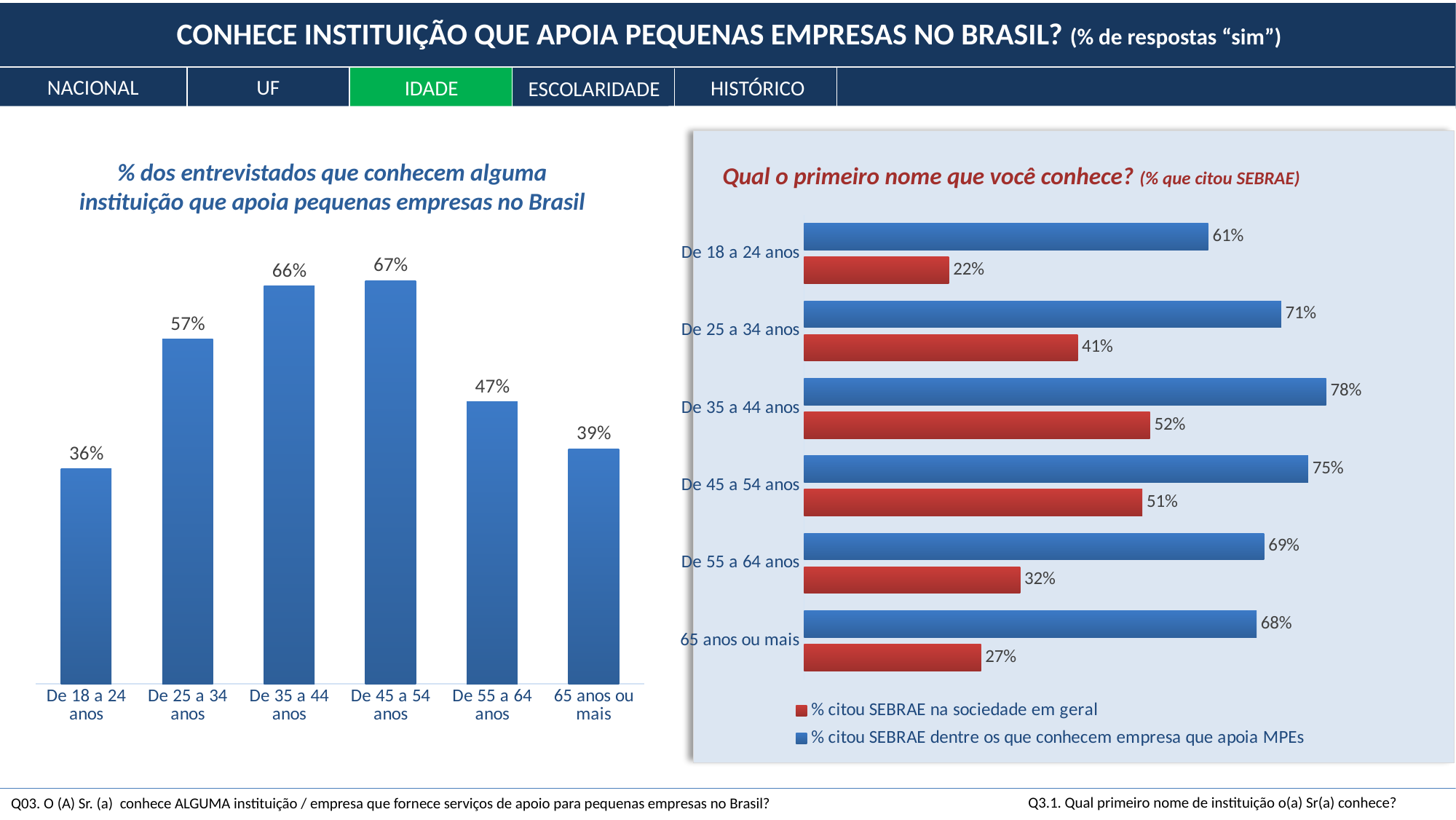
In the left chart, which age group has the highest percentage? De 45 a 54 anos In the left chart, what is the difference between the values for 'De 35 a 44 anos' and 'De 55 a 64 anos'? 19 percentage points In the left chart, what percentage of respondents aged 'De 18 a 24 anos' know an institution that supports small businesses in Brazil? 36% In the right chart 'Qual o primeiro nome que você conhece?', how many series does the legend list? 2 In the right chart 'Qual o primeiro nome que você conhece?', what is the value of '% citou SEBRAE dentre os que conhecem empresa que apoia MPEs' for '65 anos ou mais'? 68% In the left chart, which age group has the lowest percentage? De 18 a 24 anos In the right chart 'Qual o primeiro nome que você conhece?', which age group has the highest value for '% citou SEBRAE dentre os que conhecem empresa que apoia MPEs'? De 35 a 44 anos What type of chart is the left chart? Bar chart In the right chart 'Qual o primeiro nome que você conhece?', which age group has the lowest value for '% citou SEBRAE na sociedade em geral'? De 18 a 24 anos In the left chart, how many age groups are shown? 6 In the right chart 'Qual o primeiro nome que você conhece?', which is larger for 'De 55 a 64 anos': '% citou SEBRAE na sociedade em geral' or '% citou SEBRAE dentre os que conhecem empresa que apoia MPEs'? % citou SEBRAE dentre os que conhecem empresa que apoia MPEs In the right chart 'Qual o primeiro nome que você conhece?', what is the value of '% citou SEBRAE na sociedade em geral' for 'De 25 a 34 anos'? 41%